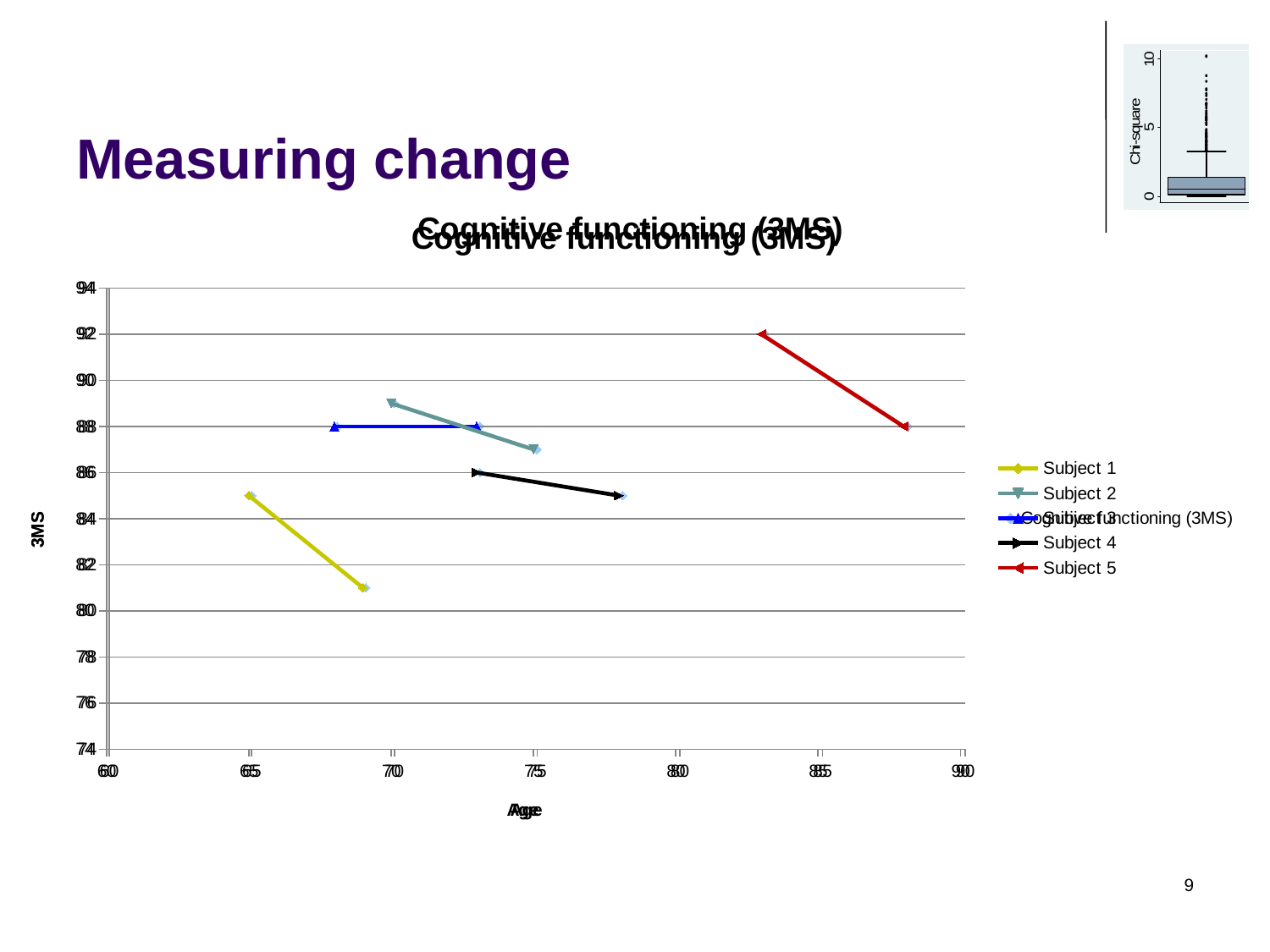
Does Subject 5's 3MS score rise or fall as age increases? fall What is the highest 3MS value reached by Subject 5? 92 What is the title of the main chart? Cognitive functioning (3MS) What is the label of the x axis of the main chart? Age Which subject has the lowest 3MS value in the main chart? Subject 1 Is the final 3MS value for Subject 1 greater or less than 84? less Which subject reaches the highest 3MS value in the main chart? Subject 5 How many subjects are plotted as lines in the main chart? 5 What kind of chart is shown on the slide under the heading 'Measuring change'? line chart At what 3MS value does Subject 3's line stay flat? 88 Is the starting 3MS value for Subject 5 greater or less than 90? greater Does Subject 1's 3MS score rise or fall as age increases? fall